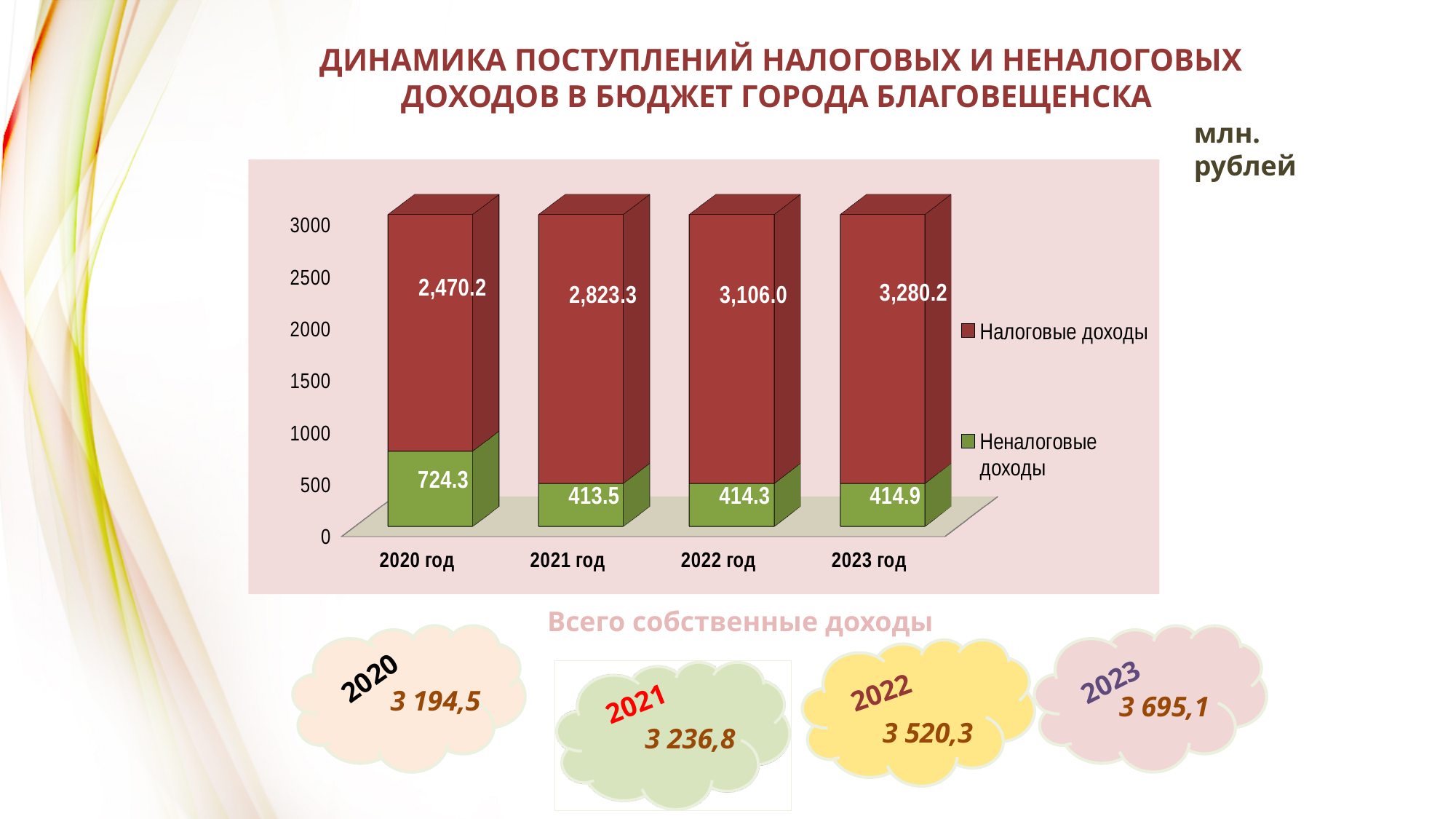
What is the value of Налоговые доходы for 2023 год? 3,280.2 Which year has the highest value of Неналоговые доходы? 2020 год Which year has the highest value of Налоговые доходы? 2023 год What is the total of the stacked bar for 2022 год? 3,520.3 Do the values of Налоговые доходы rise or fall from 2020 год to 2023 год? rise Which is larger: Неналоговые доходы in 2020 год or in 2021 год? 2020 год What is the difference between Налоговые доходы in 2023 год and 2020 год? 810.0 What type of chart is shown on the slide? stacked bar chart What is the value of Неналоговые доходы for 2020 год? 724.3 How many series does the legend list? 2 How many years are shown on the x axis of the chart? 4 What is the value of Налоговые доходы for 2021 год? 2,823.3